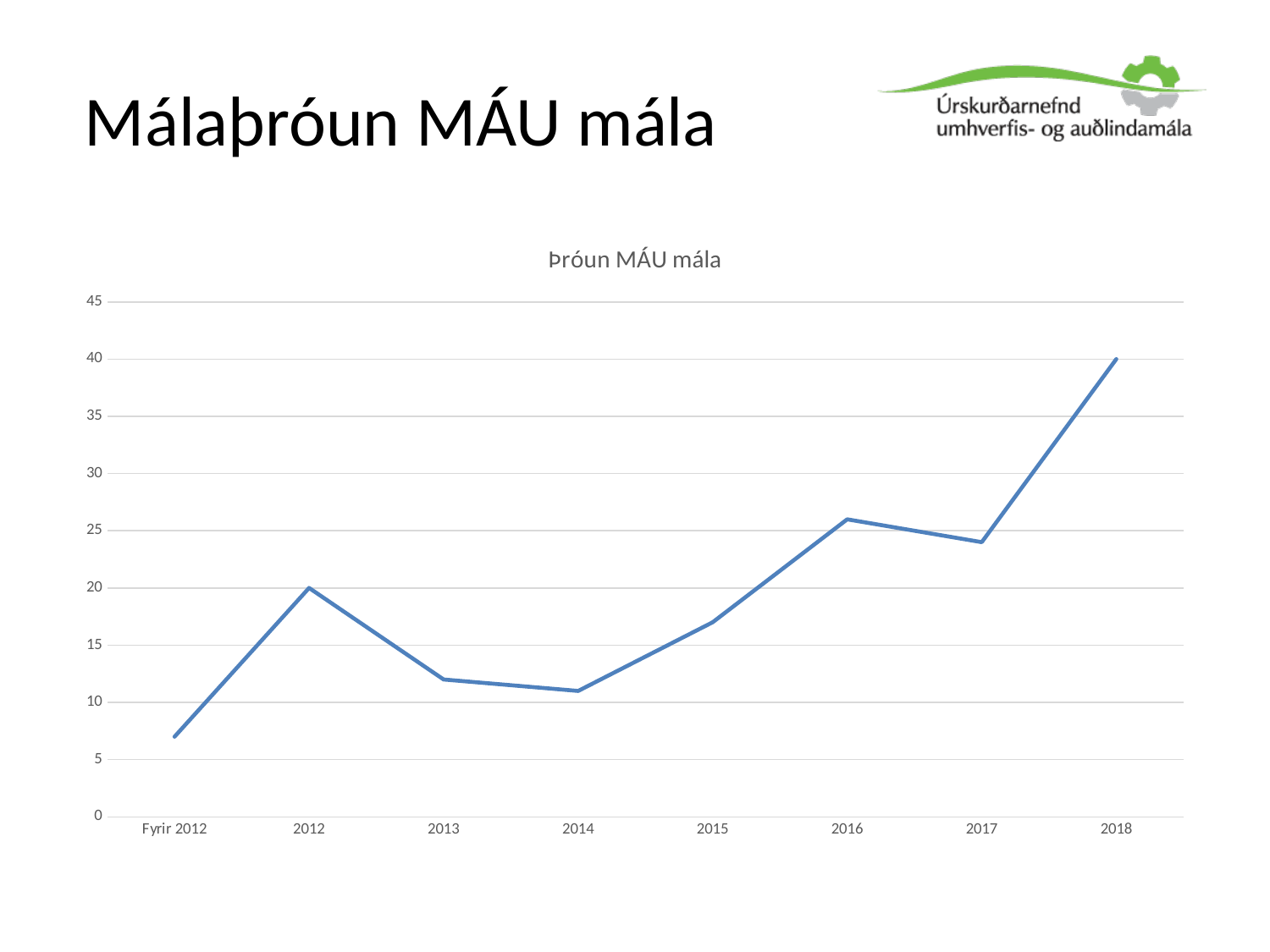
What is the value for 2018? 40 What is the title of the chart? Þróun MÁU mála Which is larger, the value for 2016 or the value for 2017? 2016 What is the difference between the values for 2018 and 2012? 20 What is the value for 2012? 20 How many points are plotted along the x axis? 8 Which category has the lowest value? Fyrir 2012 What kind of chart is shown on the slide? line chart Do the values generally rise or fall from Fyrir 2012 to 2018? rise Which year has the highest value? 2018 Is the value for 2014 greater or less than 15? less